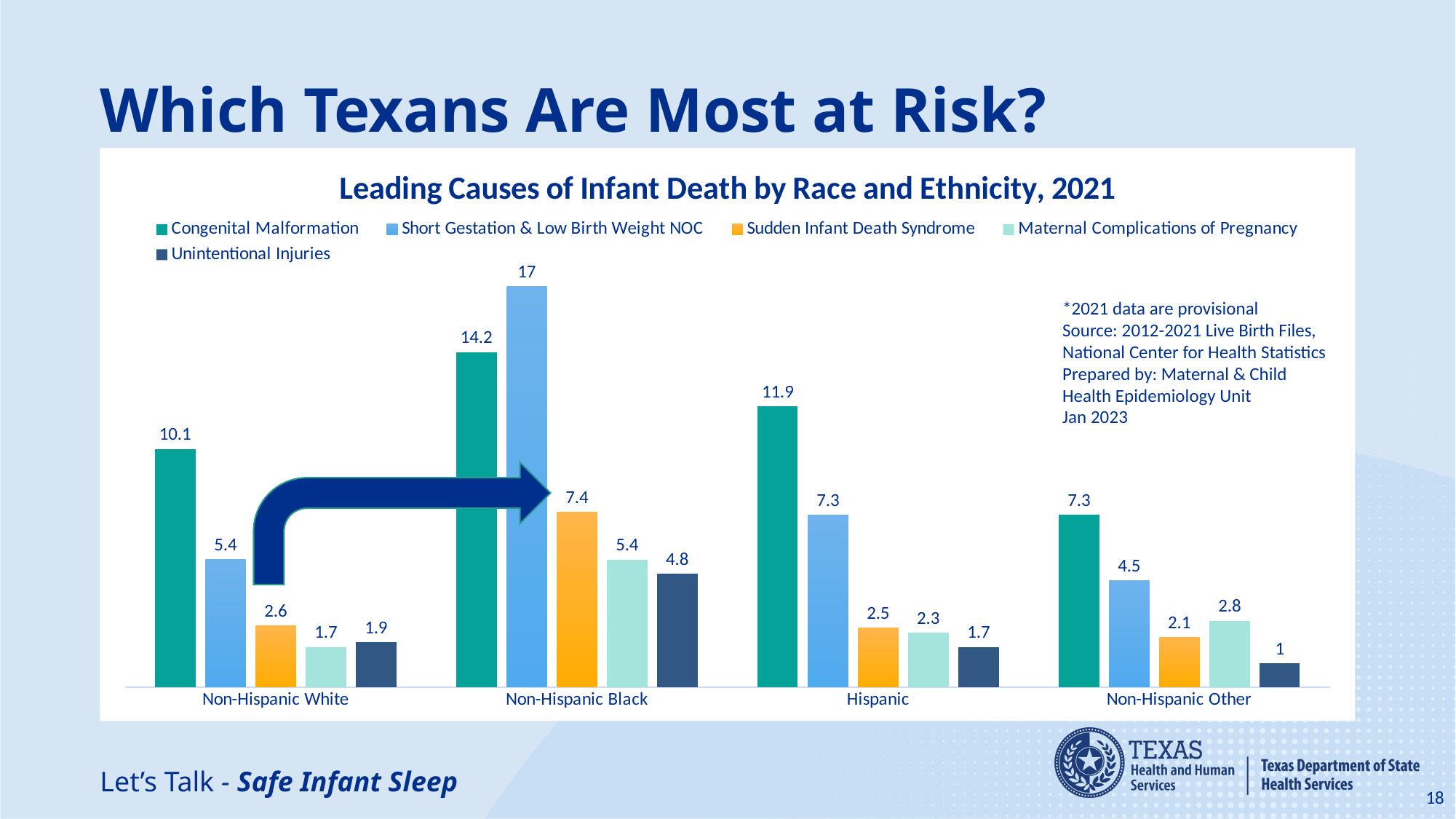
What is the value for Sudden Infant Death Syndrome in the Non-Hispanic White group? 2.6 Which race/ethnicity group has the lowest value for Congenital Malformation? Non-Hispanic Other What is the value for Unintentional Injuries in the Non-Hispanic Other group? 1 Which series is shown in orange in the legend? Sudden Infant Death Syndrome Which is larger: Sudden Infant Death Syndrome for Non-Hispanic Black or for Hispanic? Non-Hispanic Black How many series does the legend list? 5 What is the difference between the Short Gestation & Low Birth Weight NOC values for Non-Hispanic Black and Non-Hispanic White? 11.6 Which race/ethnicity group has the highest value for Short Gestation & Low Birth Weight NOC? Non-Hispanic Black What is the title of the chart? Leading Causes of Infant Death by Race and Ethnicity, 2021 What kind of chart is shown on the slide? Bar chart What is the value for Congenital Malformation in the Non-Hispanic Black group? 14.2 How many race/ethnicity categories are shown on the x axis? 4